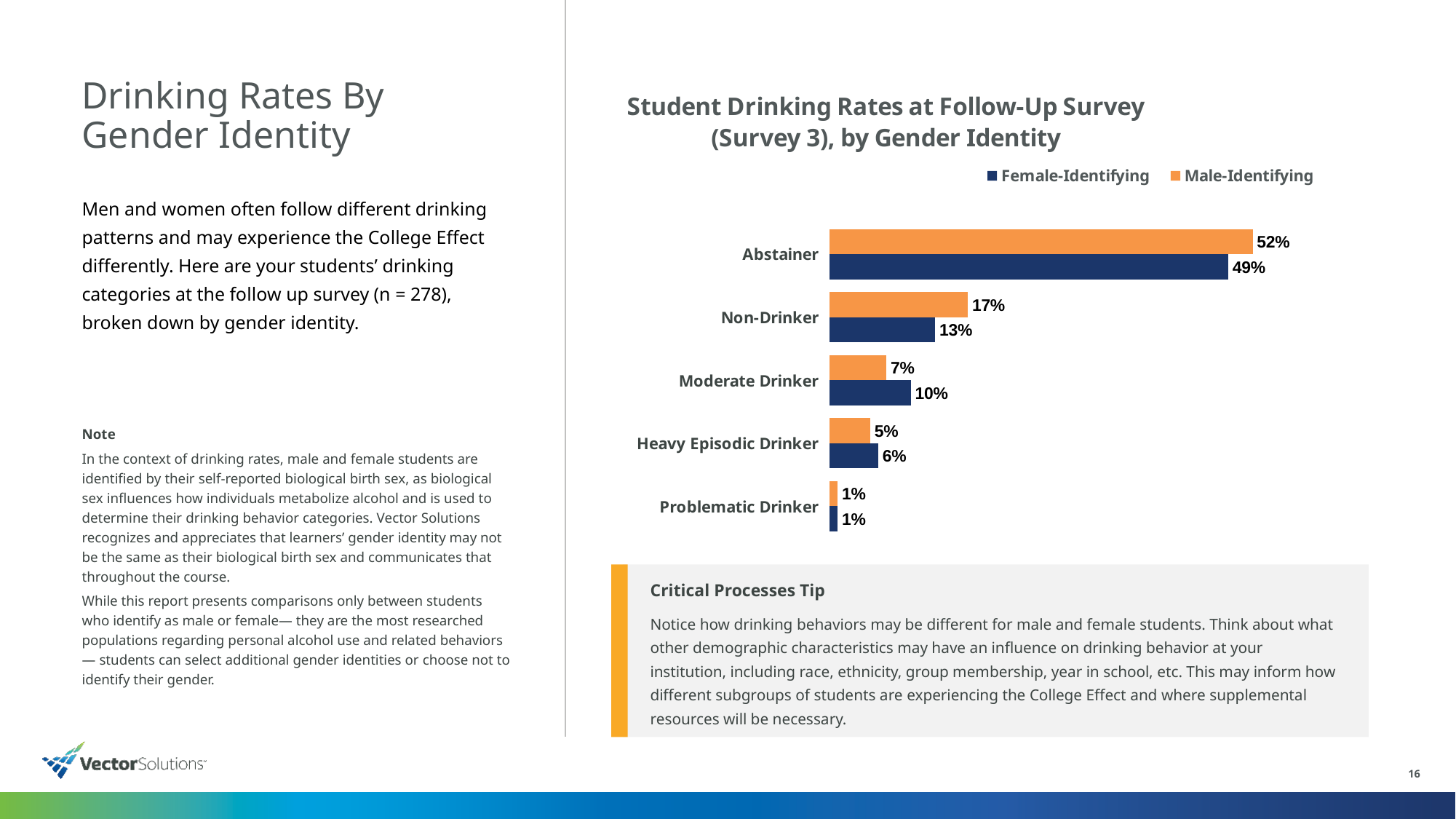
How many series does the legend list? 2 What is the Female-Identifying value for Non-Drinker? 13% How many drinking categories are shown on the chart? 5 Which category has the lowest Male-Identifying value? Problematic Drinker What is the Male-Identifying value for Abstainer? 52% What kind of chart is shown on the slide? Bar chart What is the Female-Identifying value for Moderate Drinker? 10% For Moderate Drinker, which is larger: the Female-Identifying value or the Male-Identifying value? Female-Identifying What is the Male-Identifying value for Heavy Episodic Drinker? 5% Which category has the highest Female-Identifying value? Abstainer What is the difference between the Male-Identifying and Female-Identifying values for Non-Drinker? 4% What is the difference between the Male-Identifying and Female-Identifying values for Abstainer? 3%